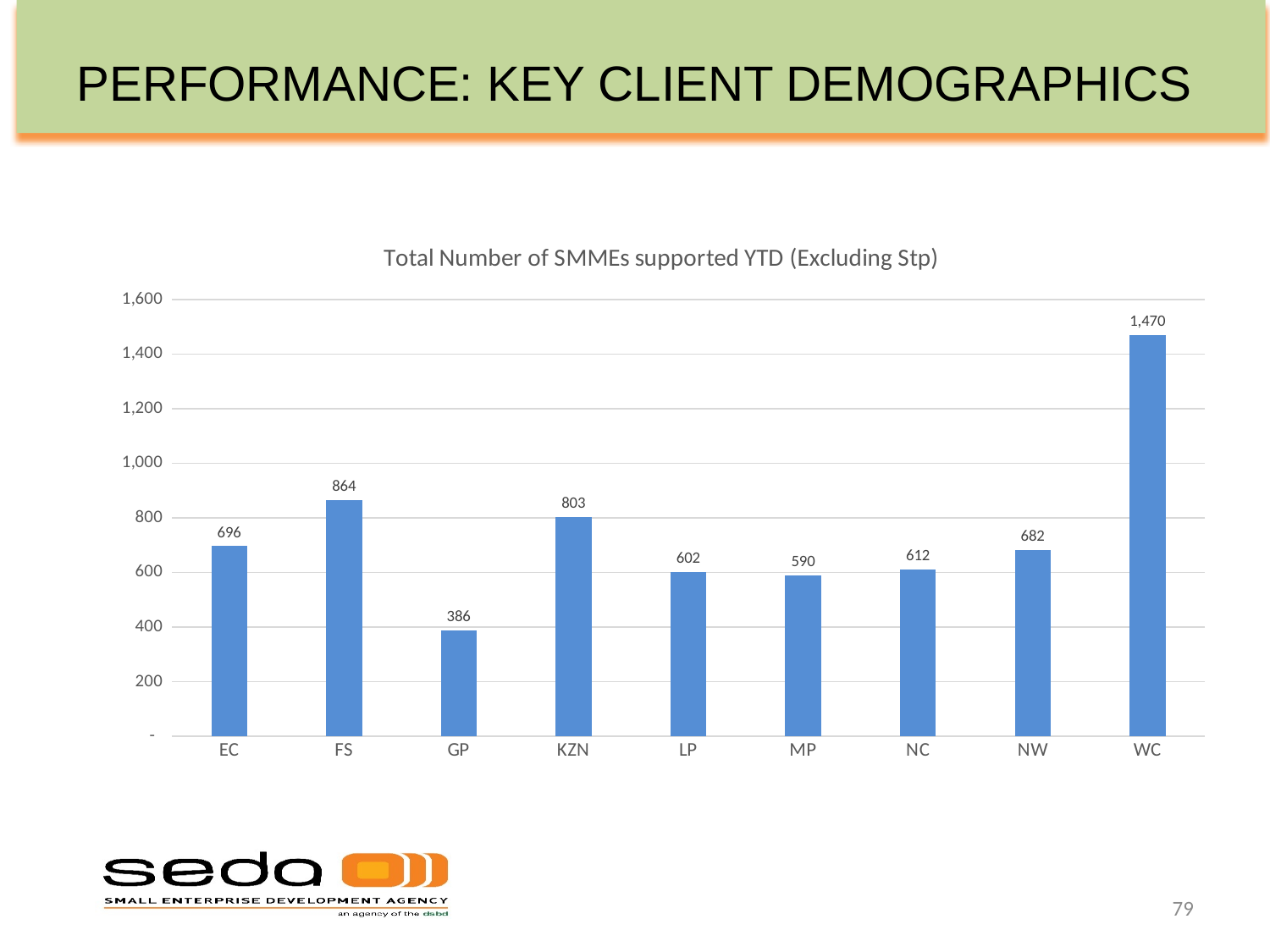
What is the title of the chart? Total Number of SMMEs supported YTD (Excluding Stp) Which province has the lowest number of SMMEs supported? GP What kind of chart is shown on the slide? Bar chart What is the difference between the values for FS and EC? 168 Which is larger, the value for NC or the value for MP? NC What is the value for KZN? 803 How many provinces are shown on the x axis? 9 Which province has the highest number of SMMEs supported? WC What is the value for WC? 1,470 What is the difference between the values for WC and GP? 1,084 Is the value for NW greater or less than 600? greater What is the value for GP? 386